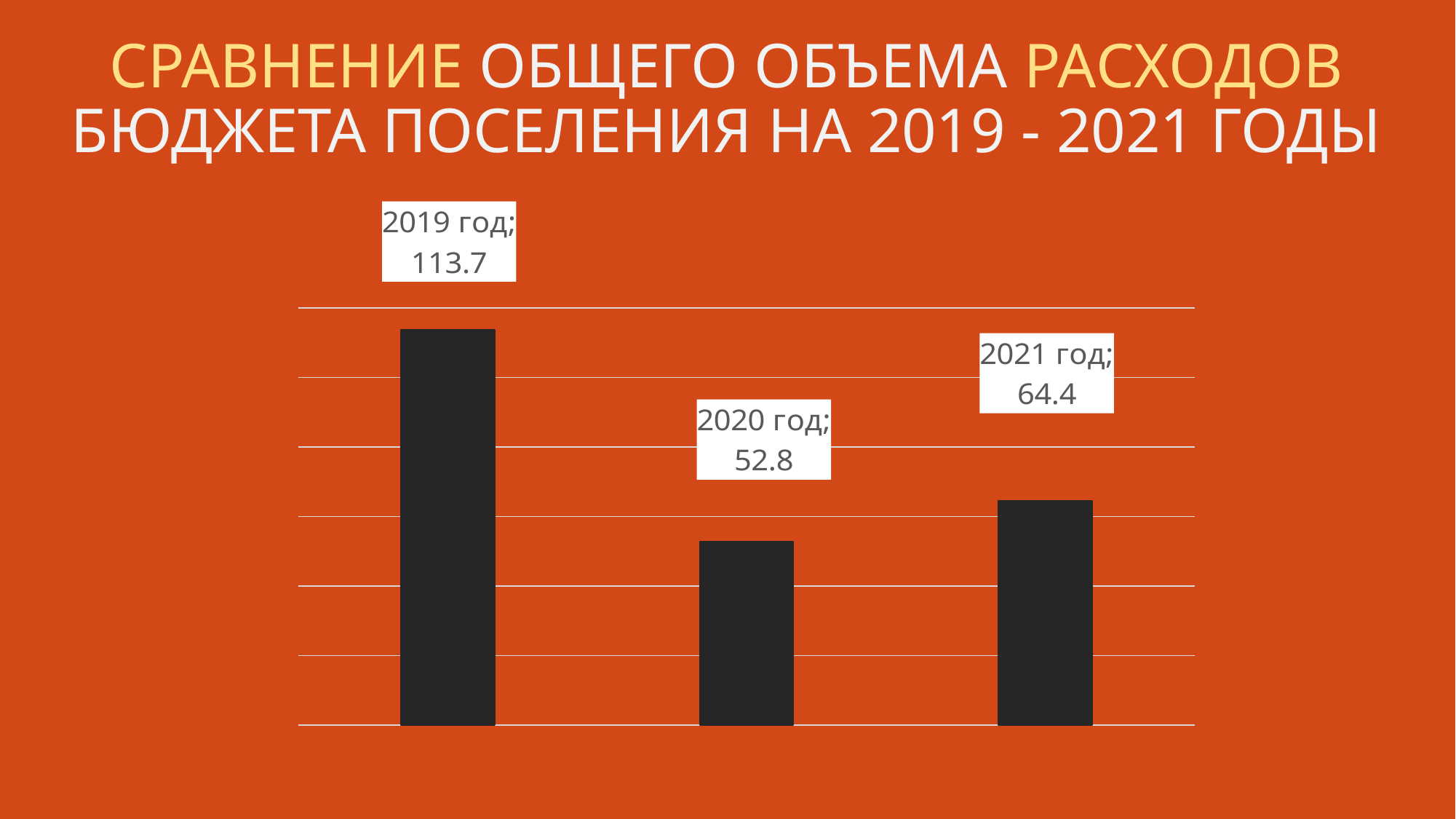
What is the value for 2021 год? 64.4 Which year has the highest value? 2019 год Does the value rise or fall from 2019 год to 2020 год? fall Which is larger, the value for 2020 год or the value for 2021 год? 2021 год What colour are the bars in the chart? dark grey What is the difference between the values for 2019 год and 2020 год? 60.9 What kind of chart is shown on the slide? bar chart What is the difference between the values for 2021 год and 2020 год? 11.6 What is the value for 2020 год? 52.8 What is the value for 2019 год? 113.7 Which year has the lowest value? 2020 год How many bars are shown in the chart? 3